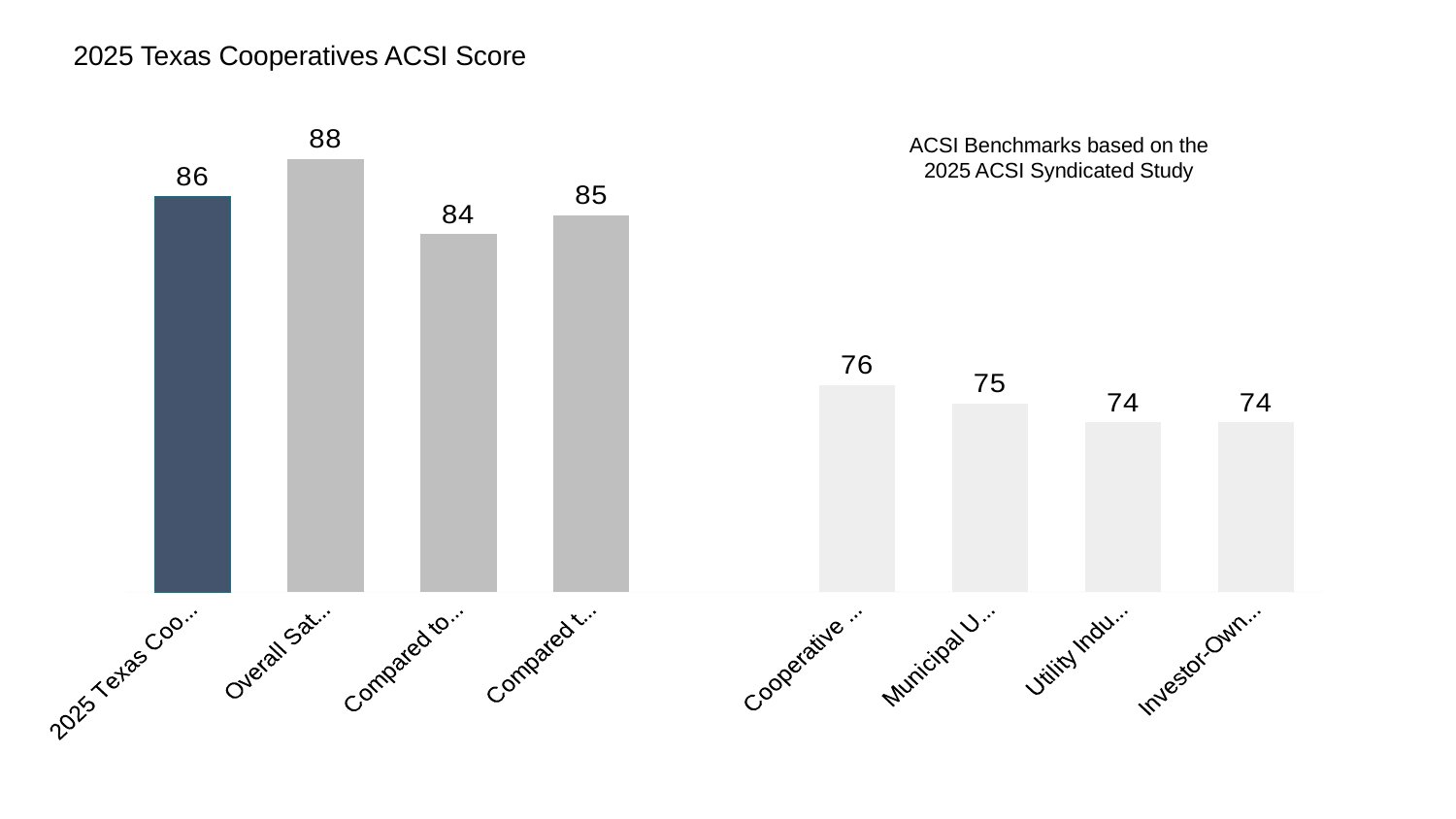
What is the value of the bar labelled "Utility Indu..."? 74 What is the difference between the first bar (86) and the "Cooperative ..." bar (76)? 10 What is the value of the bar labelled "Municipal U..."? 75 What type of chart is shown on the slide? bar chart How many bars are plotted in the chart? 8 What is the title of the chart? 2025 Texas Cooperatives ACSI Score Which bar has the highest value in the chart? Overall Sat... (88) Which is larger: the first bar "2025 Texas Coo..." or the bar labelled "Cooperative ..."? 2025 Texas Coo... What is the lowest value shown in the chart? 74 What is the difference between the "Overall Sat..." bar (88) and the third bar (84)? 4 What is the value of the bar labelled "Overall Sat..."? 88 What is the value of the first (dark blue) bar, labelled "2025 Texas Coo..."? 86